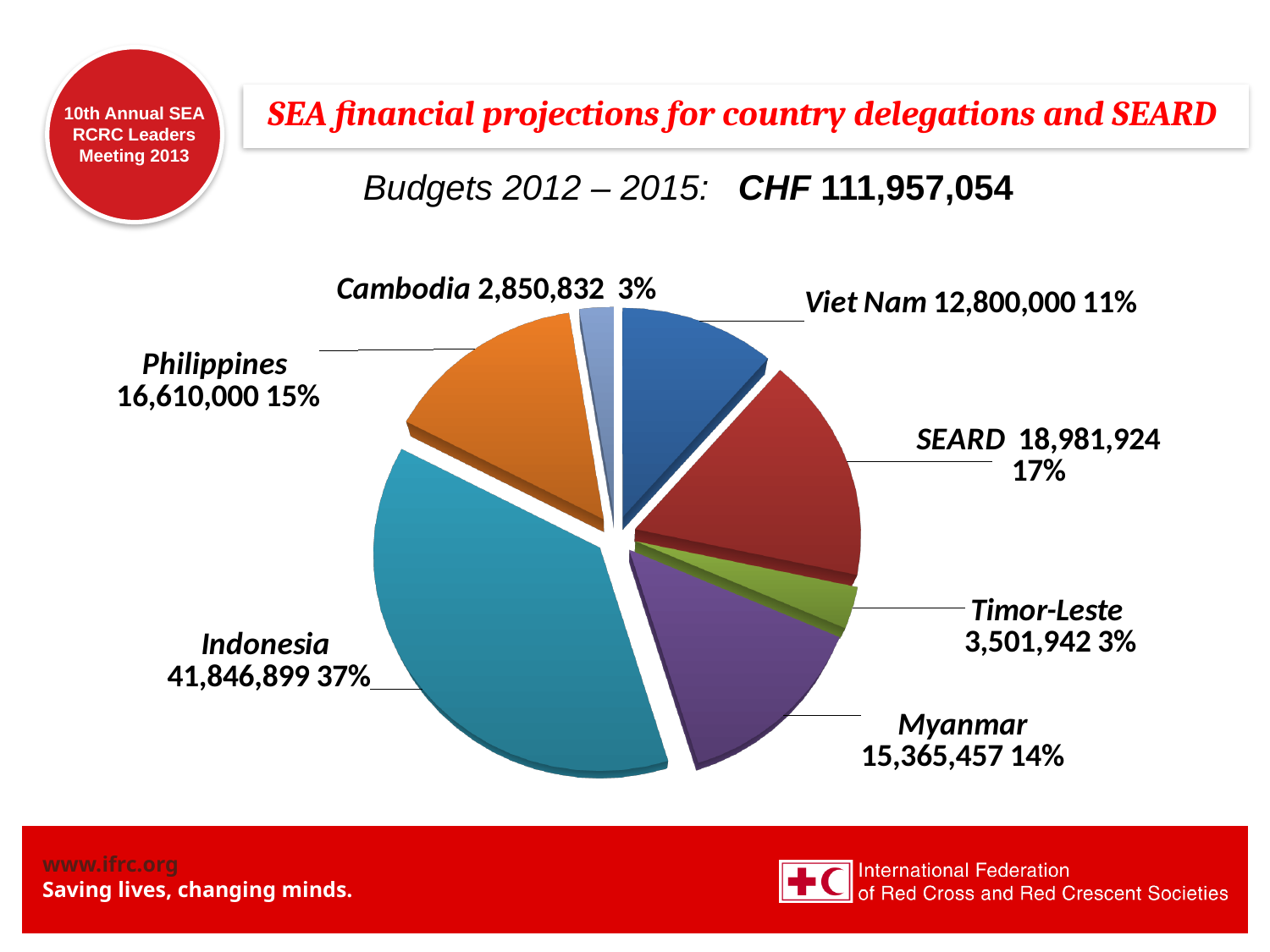
What is the budget value shown for Viet Nam? 12,800,000 What is the budget value shown for Indonesia? 41,846,899 Which category has the largest slice of the pie chart? Indonesia What total budget for 2012 – 2015 is stated above the chart? CHF 111,957,054 What kind of chart is shown on the slide? Pie chart What is the difference between the budget values for Timor-Leste and Cambodia? 651,110 How many categories are shown in the pie chart? 7 Which category has the smallest budget value in the pie chart? Cambodia What percentage share does SEARD have in the pie chart? 17% What percentage share does Myanmar have in the pie chart? 14% Which has a larger budget value, Philippines or Myanmar? Philippines What is the difference between the budget values for Indonesia and SEARD? 22,864,975